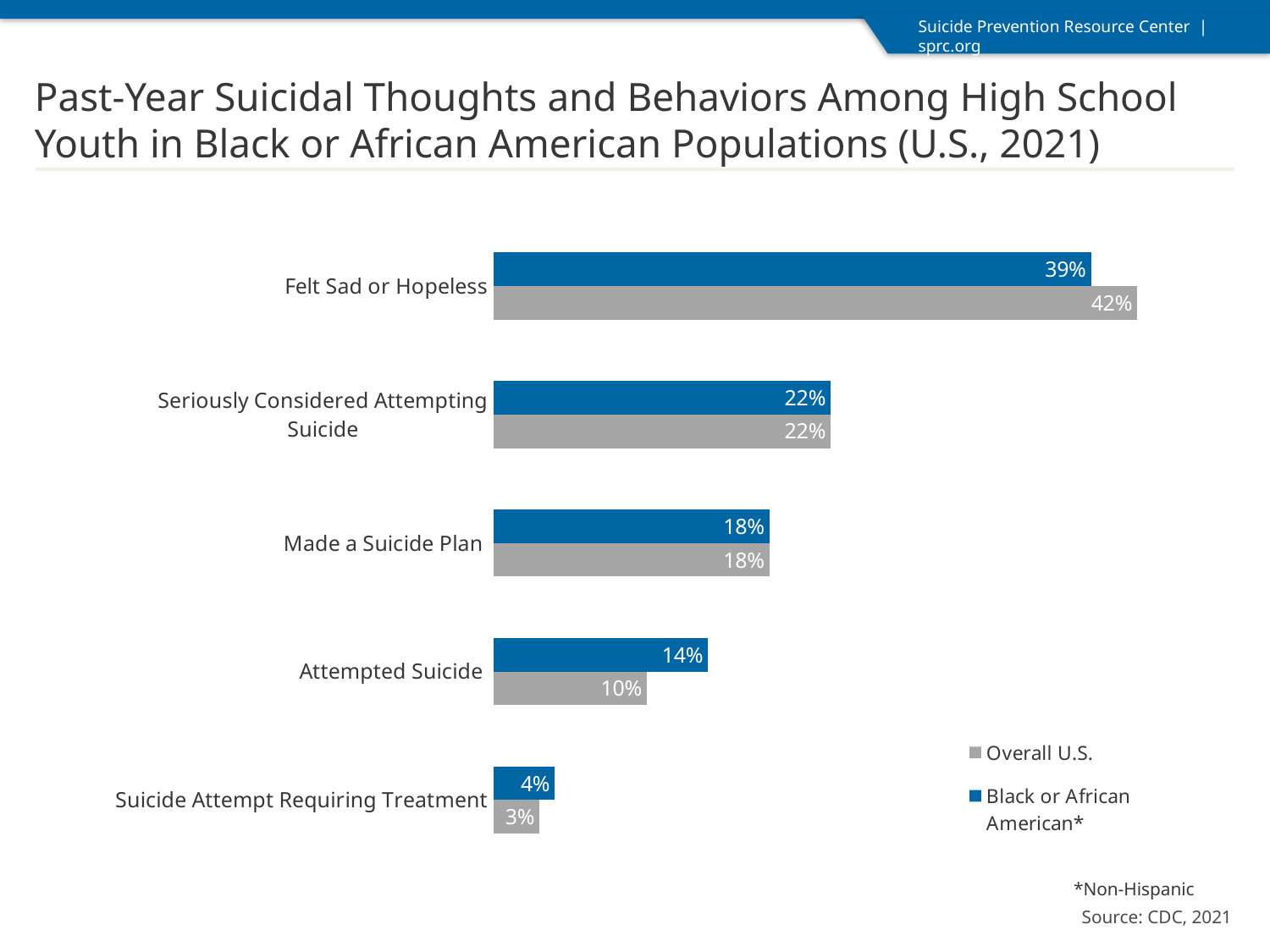
How many categories are shown on the chart? 5 What is the Overall U.S. value for Felt Sad or Hopeless? 42% What is the Overall U.S. value for Attempted Suicide? 10% For Attempted Suicide, which is larger: the Overall U.S. value or the Black or African American value? Black or African American What is the value for Black or African American youth for Suicide Attempt Requiring Treatment? 4% How many series does the legend list? 2 What is the value for Black or African American youth who Felt Sad or Hopeless? 39% What is the difference between the Overall U.S. and Black or African American values for Felt Sad or Hopeless? 3% What is the difference between the Black or African American and Overall U.S. values for Attempted Suicide? 4% Which category has the highest value for the Black or African American series? Felt Sad or Hopeless Which category has the lowest Overall U.S. value? Suicide Attempt Requiring Treatment What kind of chart is shown on the slide? Bar chart